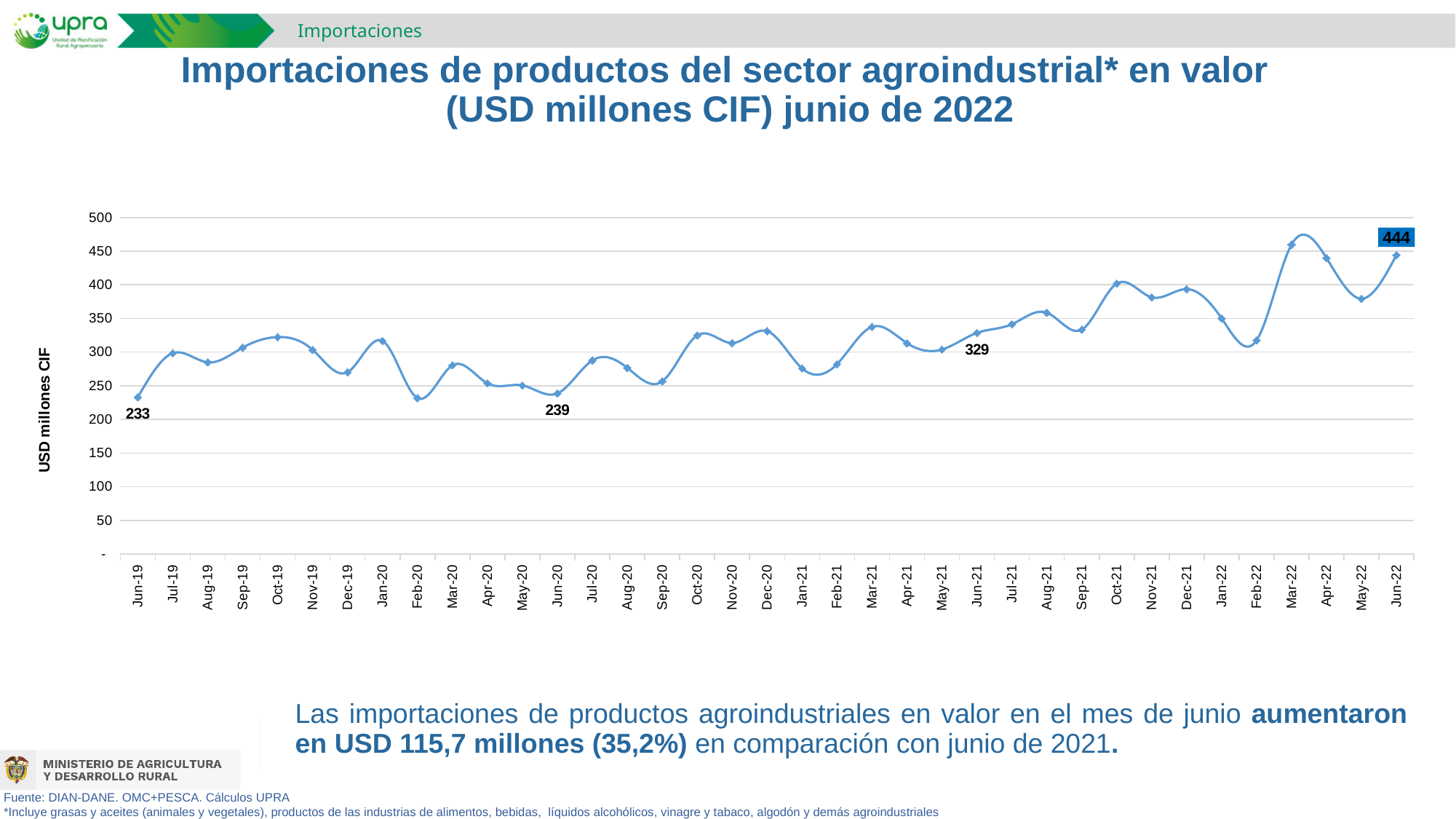
What is the value for Jun-20? 239 What is the difference between the values for Jun-21 and Jun-20? 90 What kind of chart is shown on the slide? line chart What is the value for Jun-22? 444 What is the difference between the values for Jun-22 and Jun-21? 115 Is the value for Feb-22 greater or less than 350? less Is the value for Mar-22 greater or less than 400? greater What is the value for Jun-19? 233 Which is larger, the value for Jun-21 or the value for Jun-20? Jun-21 What is the label of the vertical axis? USD millones CIF What is the value for Jun-21? 329 How many monthly data points are plotted on the chart? 37